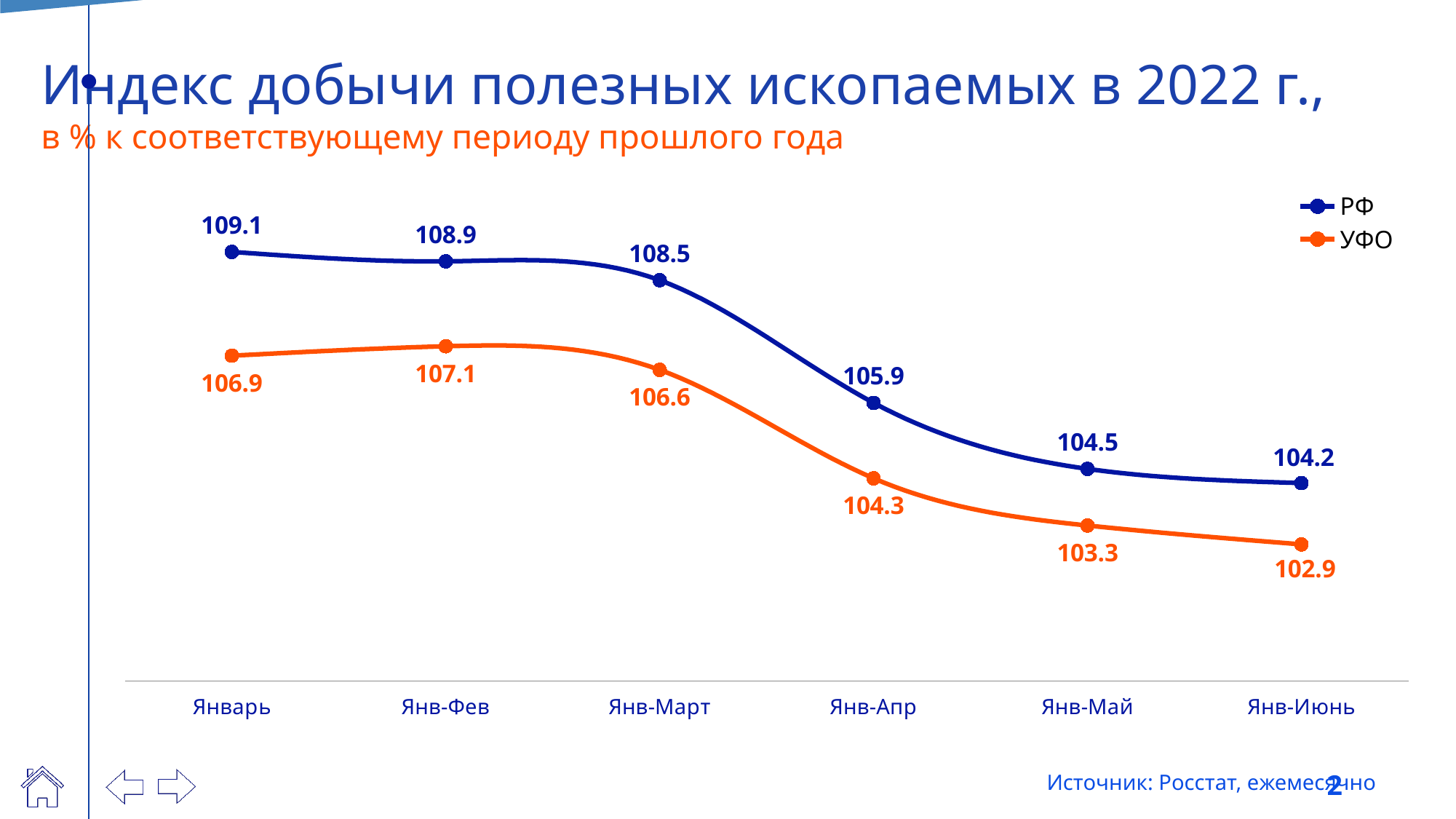
What colour is the УФО line? orange What is the value for УФО in Янв-Май? 103.3 What is the difference between РФ and УФО in Янв-Апр? 1.6 What is the value for РФ in Янв-Март? 108.5 In which period is the РФ series highest? Январь Does the РФ series rise or fall from Янв-Март to Янв-Июнь? fall What is the value for УФО in Январь? 106.9 How many periods are shown on the x axis? 6 Which is larger in Янв-Июнь, РФ or УФО? РФ In which period is the УФО series lowest? Янв-Июнь How many series does the legend list? 2 What kind of chart is shown? line chart